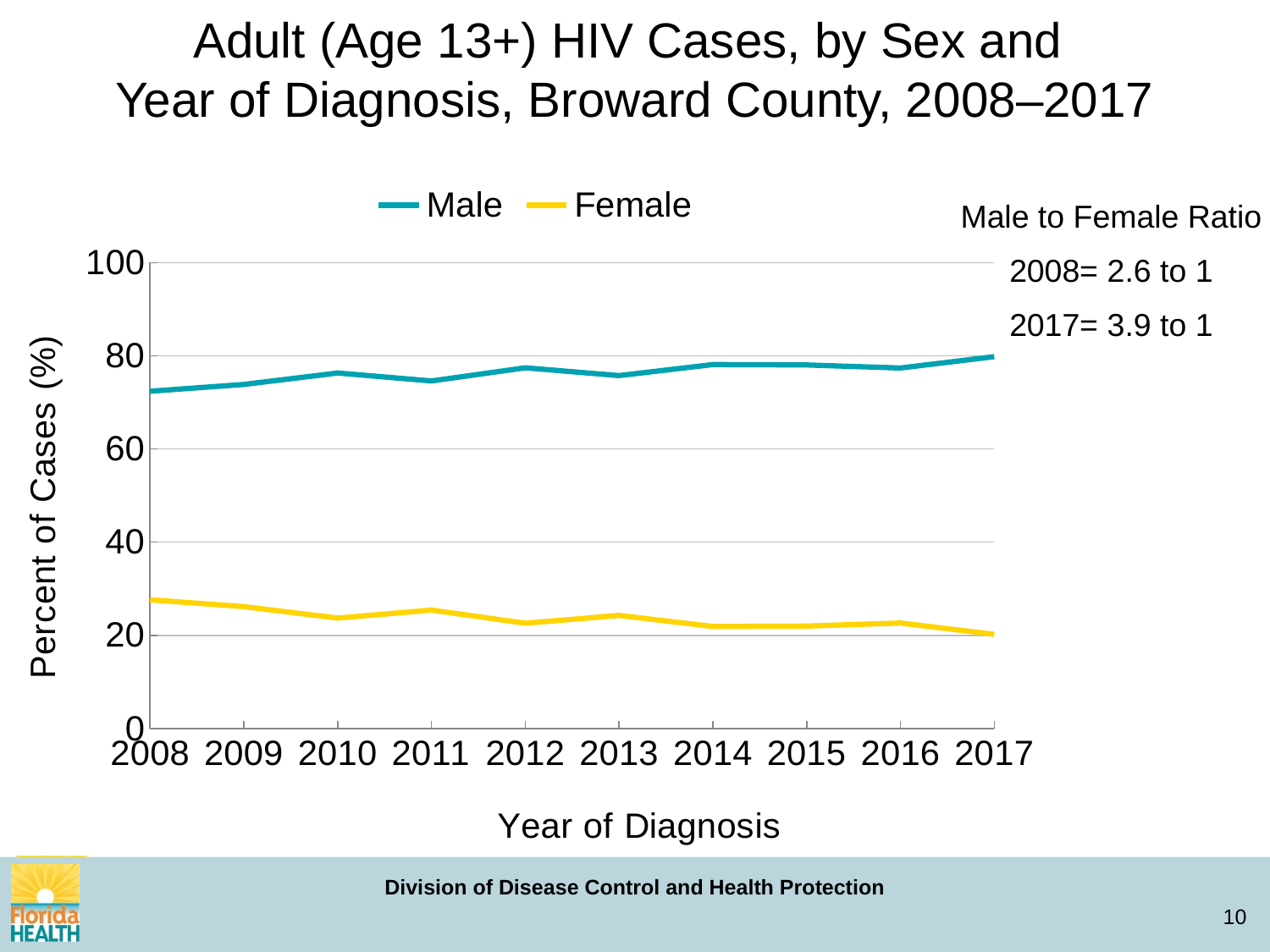
Which series has the larger value in 2013, Male or Female? Male What kind of chart is shown on the slide? Line chart Is the value for Male in 2017 greater or less than 60? greater Is the value for Female in 2008 greater or less than 40? less What is the label of the y axis? Percent of Cases (%) Is the value for Male in 2008 greater or less than 60? greater Does the Male line rise or fall overall from 2008 to 2017? Rise Does the Female line rise or fall overall from 2008 to 2017? Fall How many series does the legend list? 2 How many years of diagnosis are plotted along the x axis? 10 What male to female ratio is given for 2017 on the slide? 3.9 to 1